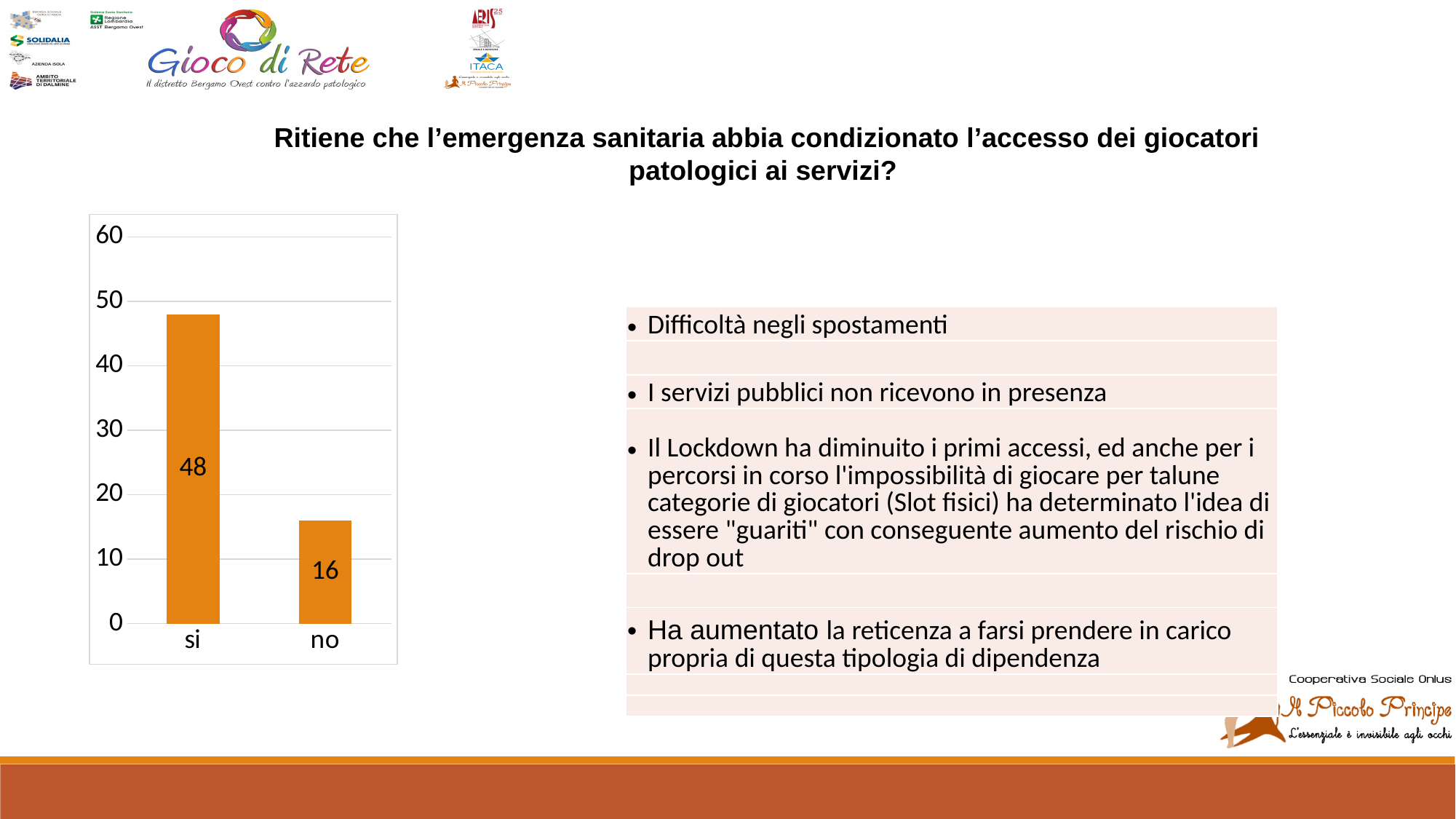
What is the difference between the values for "si" and "no"? 32 What is the total of the values for "si" and "no"? 64 What is the value for "no"? 16 Is the value for "no" greater or less than 20? less What colour are the bars in the chart? orange Is the value for "si" greater or less than 40? greater What kind of chart is shown on the slide? bar chart Which category has the highest value? si How many categories are shown in the chart? 2 Which category has the lowest value? no Which is larger, the value for "si" or the value for "no"? si What is the value for "si"? 48